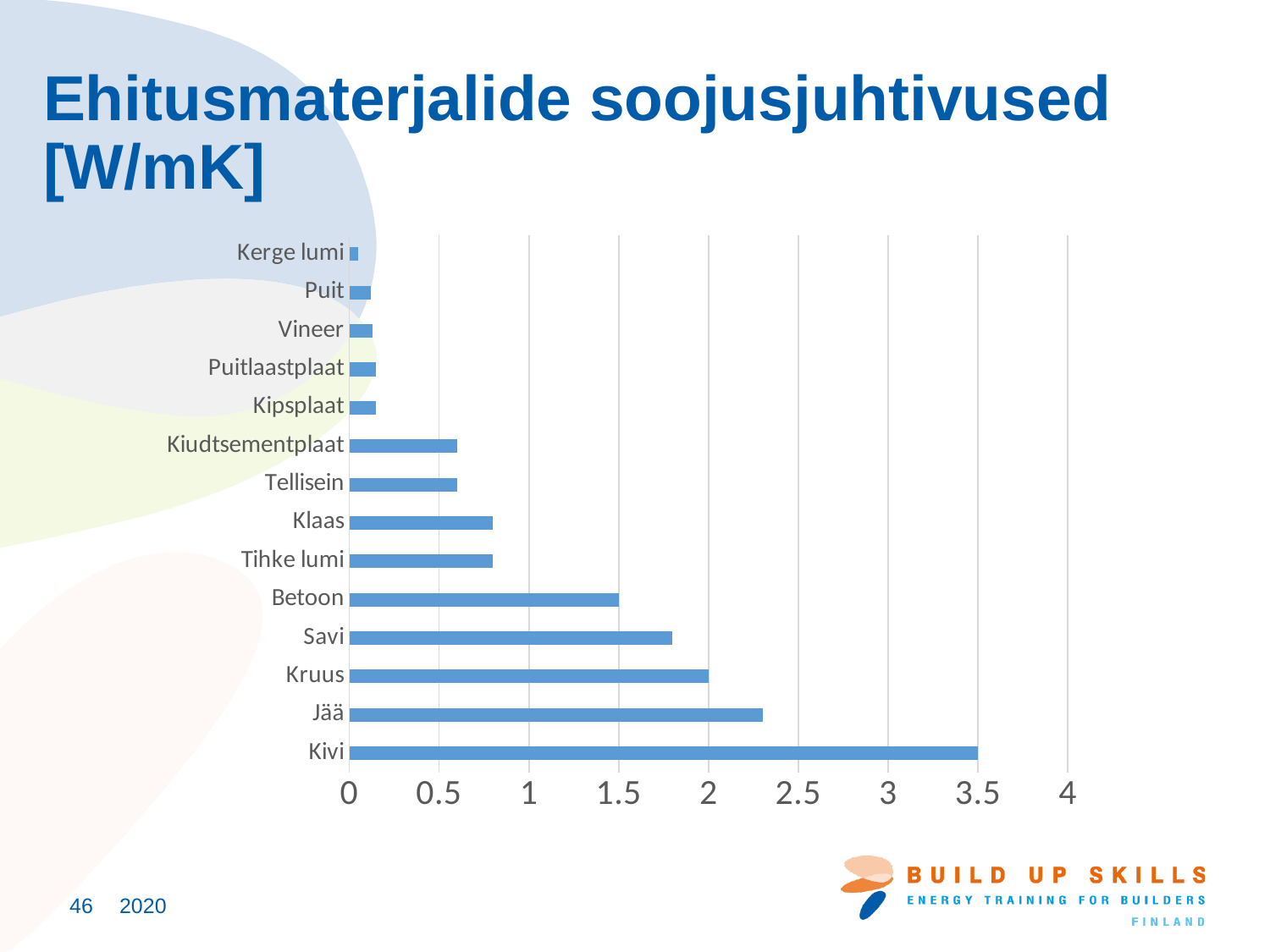
How many materials (categories) are plotted in the chart? 14 What is the value for Betoon? 1.5 What is the value for Kivi? 3.5 What is the value for Kruus? 2 What kind of chart is shown on the slide? bar chart Is the value for Savi greater or less than 2? less Which material has the lowest thermal conductivity in the chart? Kerge lumi Which material has the highest thermal conductivity in the chart? Kivi What is the title of the slide containing the chart? Ehitusmaterjalide soojusjuhtivused [W/mK] What is the difference between the values for Kivi and Kruus? 1.5 Which has the larger value, Jää or Savi? Jää Is the value for Jää greater or less than 2? greater